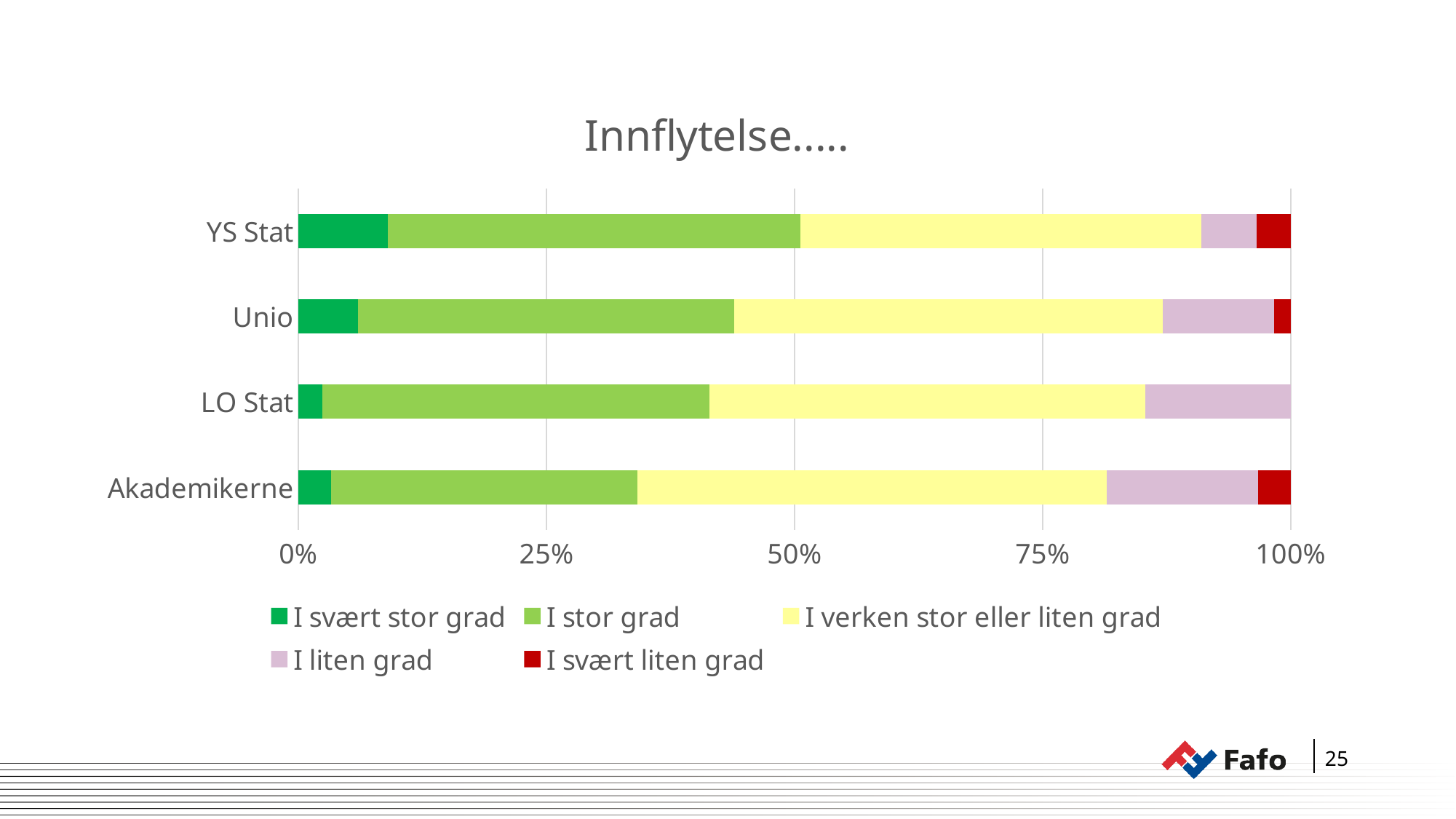
Is the combined share of 'I svært stor grad' and 'I stor grad' for LO Stat greater or less than 50%? less Is the 'I svært stor grad' segment larger for YS Stat or for LO Stat? YS Stat Is the combined share of 'I svært stor grad' and 'I stor grad' for Unio greater or less than 50%? less Which category has the largest 'I svært stor grad' segment? YS Stat Is the 'I stor grad' segment larger for YS Stat or for Akademikerne? YS Stat Which category has the largest 'I stor grad' segment? YS Stat Which category shows no 'I svært liten grad' segment? LO Stat How many series does the legend list? 5 How many categories (organisations) are shown on the chart? 4 What is the title of the chart? Innflytelse..... Is the combined share of 'I svært stor grad' and 'I stor grad' for Akademikerne greater or less than 25%? greater What kind of chart is shown on the slide? Stacked bar chart